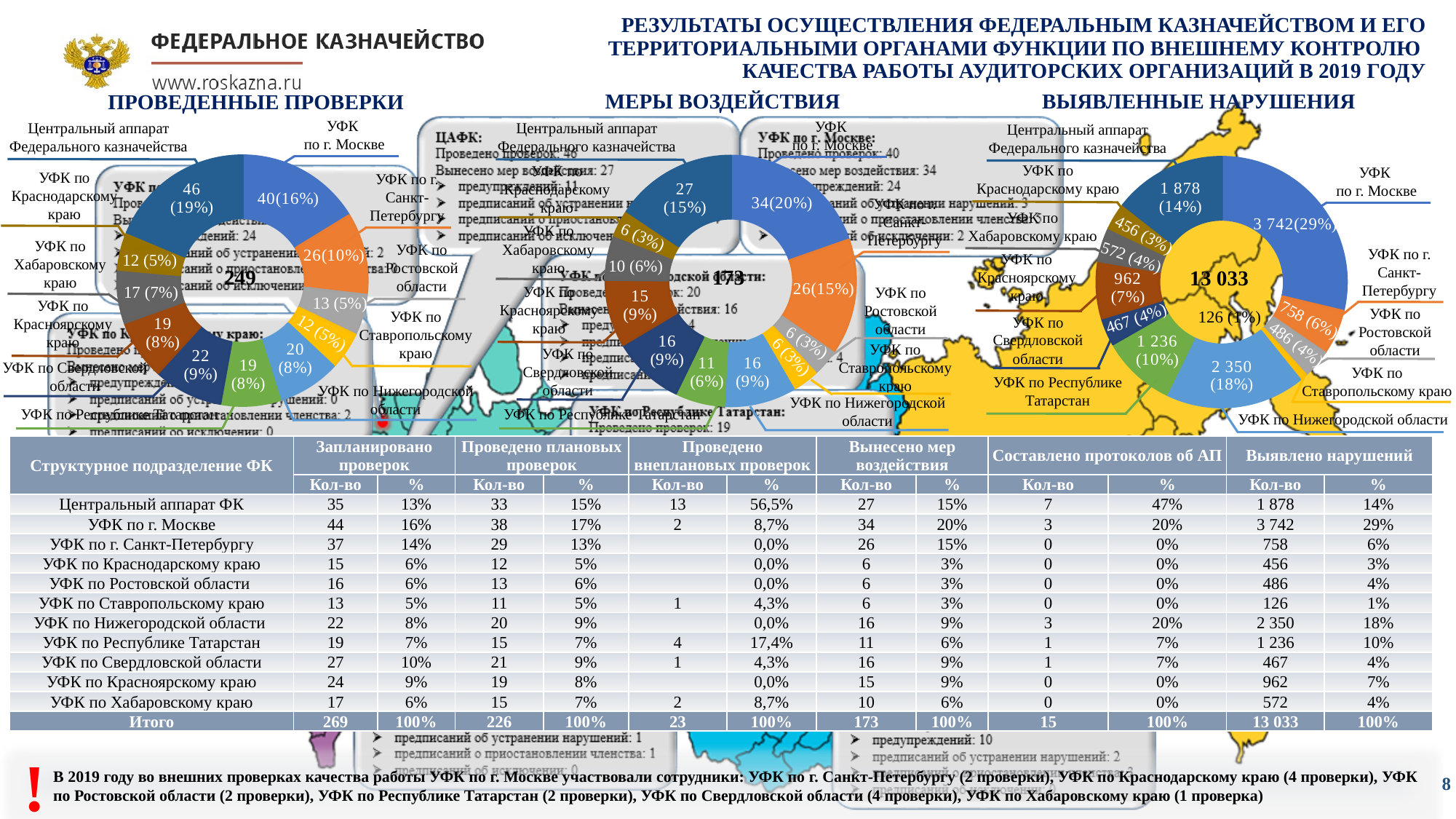
What kind of chart is used under the heading «ПРОВЕДЕННЫЕ ПРОВЕРКИ»? Donut (pie) chart In the «ПРОВЕДЕННЫЕ ПРОВЕРКИ» chart, what value is shown for Центральный аппарат Федерального казначейства? 46 (19%) In the «МЕРЫ ВОЗДЕЙСТВИЯ» chart, what total is printed in the centre of the donut? 173 In the «ВЫЯВЛЕННЫЕ НАРУШЕНИЯ» chart, which segment is the smallest? УФК по Ставропольскому краю In the «ПРОВЕДЕННЫЕ ПРОВЕРКИ» chart, which segment is the largest? Центральный аппарат Федерального казначейства In the «МЕРЫ ВОЗДЕЙСТВИЯ» chart, what value is shown for УФК по г. Москве? 34 (20%) In the «ПРОВЕДЕННЫЕ ПРОВЕРКИ» chart, what total is printed in the centre of the donut? 249 In the «ВЫЯВЛЕННЫЕ НАРУШЕНИЯ» chart, which is larger: the value for УФК по Республике Татарстан or for УФК по Красноярскому краю? УФК по Республике Татарстан In the «ВЫЯВЛЕННЫЕ НАРУШЕНИЯ» chart, what share of the total does УФК по Нижегородской области account for? 18% In the «ВЫЯВЛЕННЫЕ НАРУШЕНИЯ» chart, what value is shown for УФК по г. Москве? 3 742 (29%) In the «МЕРЫ ВОЗДЕЙСТВИЯ» chart, what is the difference between the values for УФК по г. Москве and Центральный аппарат Федерального казначейства? 7 How many segments does the «ВЫЯВЛЕННЫЕ НАРУШЕНИЯ» donut chart have? 11